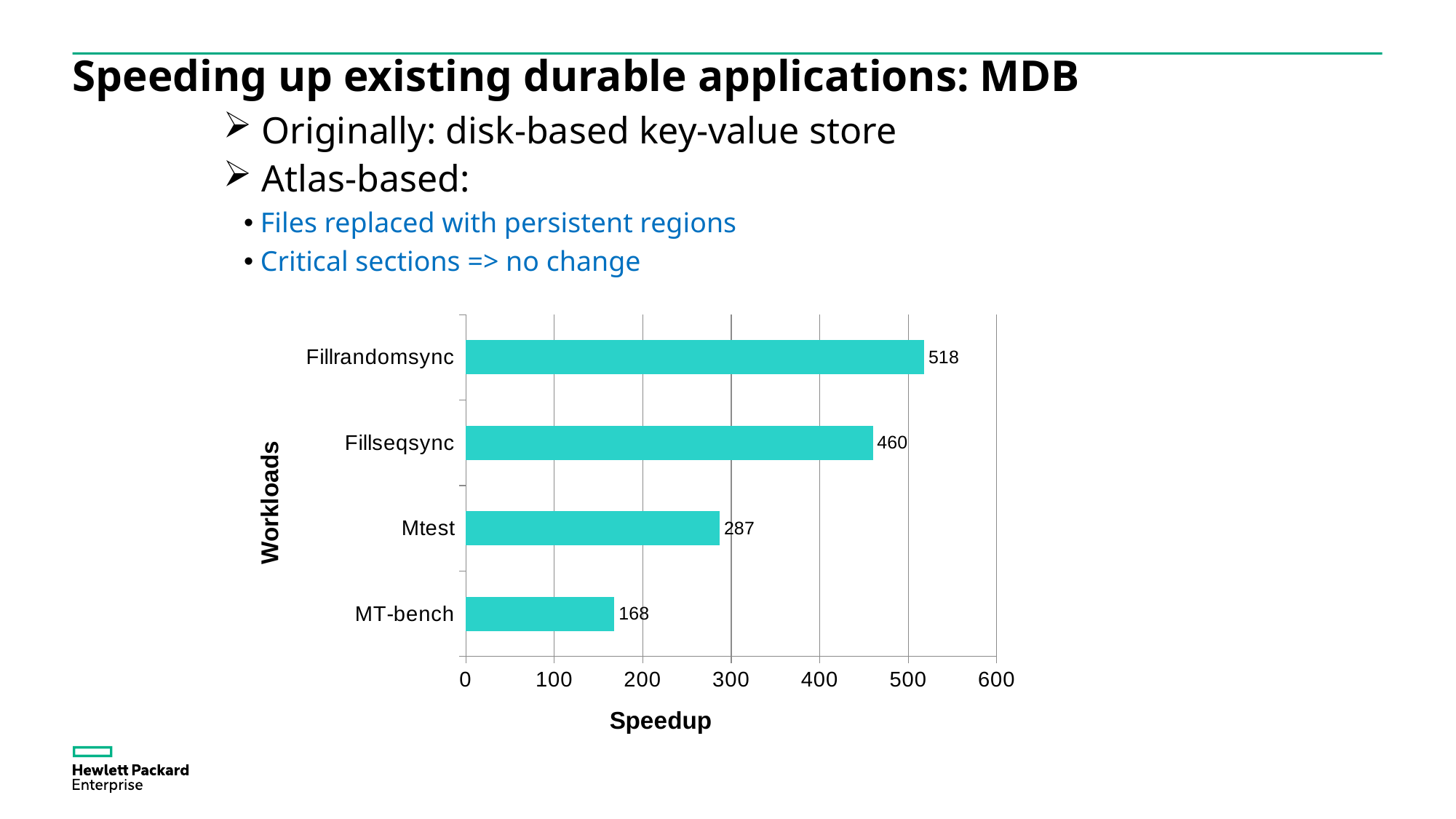
What type of chart is shown on the slide? bar chart What is the speedup value for Fillseqsync? 460 What is the speedup value for Mtest? 287 Which workload has the lowest speedup? MT-bench How many workloads are shown in the chart? 4 Which has a larger speedup, Mtest or Fillseqsync? Fillseqsync Which workload has the highest speedup? Fillrandomsync Is the speedup for Mtest greater or less than 300? less What is the difference in speedup between Fillrandomsync and Fillseqsync? 58 What is the speedup value for MT-bench? 168 What is the speedup value for Fillrandomsync? 518 What is the difference in speedup between Mtest and MT-bench? 119